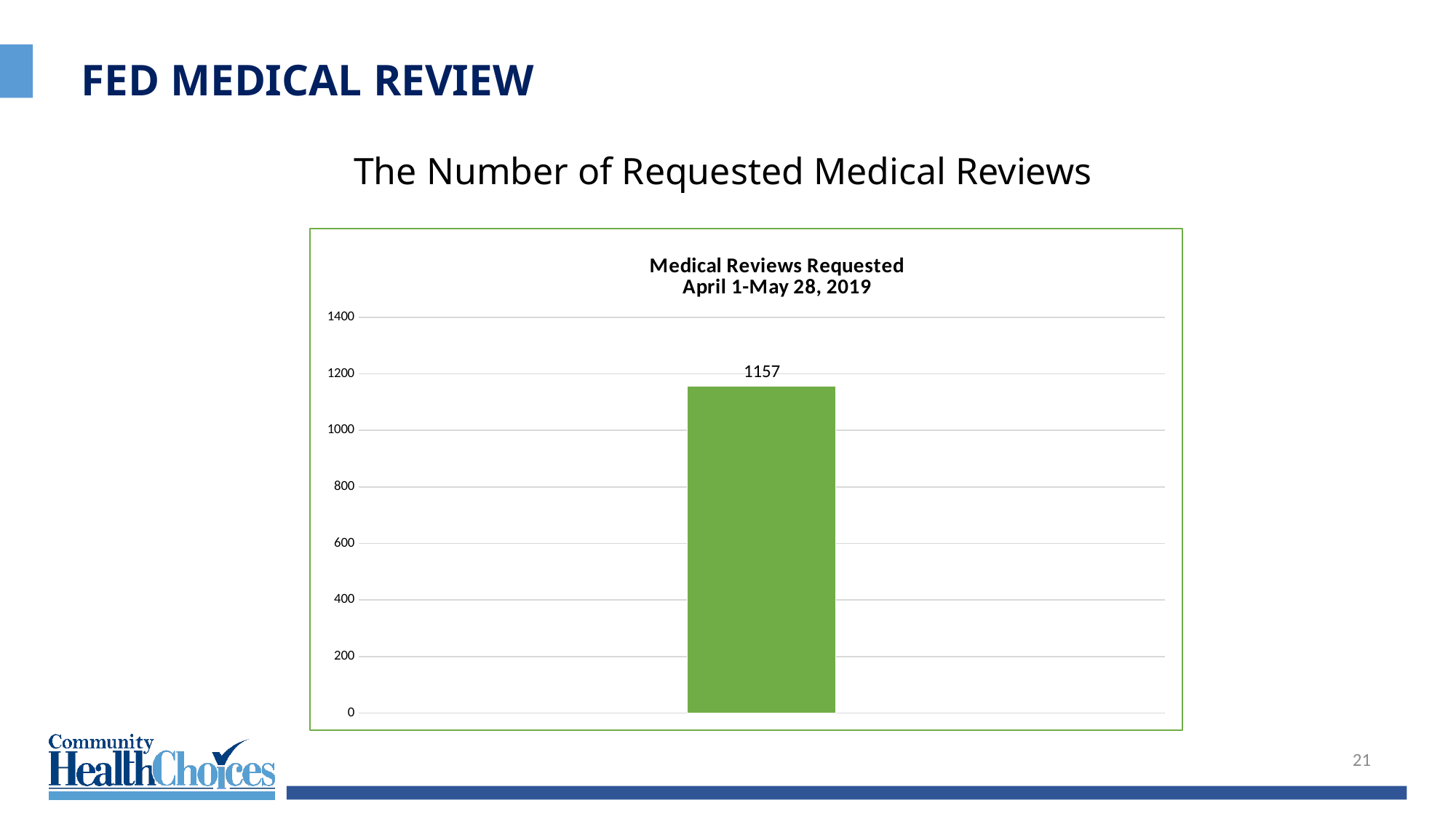
How many bars are plotted in the chart? 1 What is the highest value shown on the vertical axis of the chart? 1400 What is the value shown by the bar in the chart? 1157 How many medical reviews were requested between April 1 and May 28, 2019, according to the chart? 1157 What colour is the bar in the chart? green Is the value of the bar greater or less than 1200? less What kind of chart is shown on the slide? bar chart Is the value of the bar greater or less than 1000? greater What is the title of the chart? Medical Reviews Requested April 1-May 28, 2019